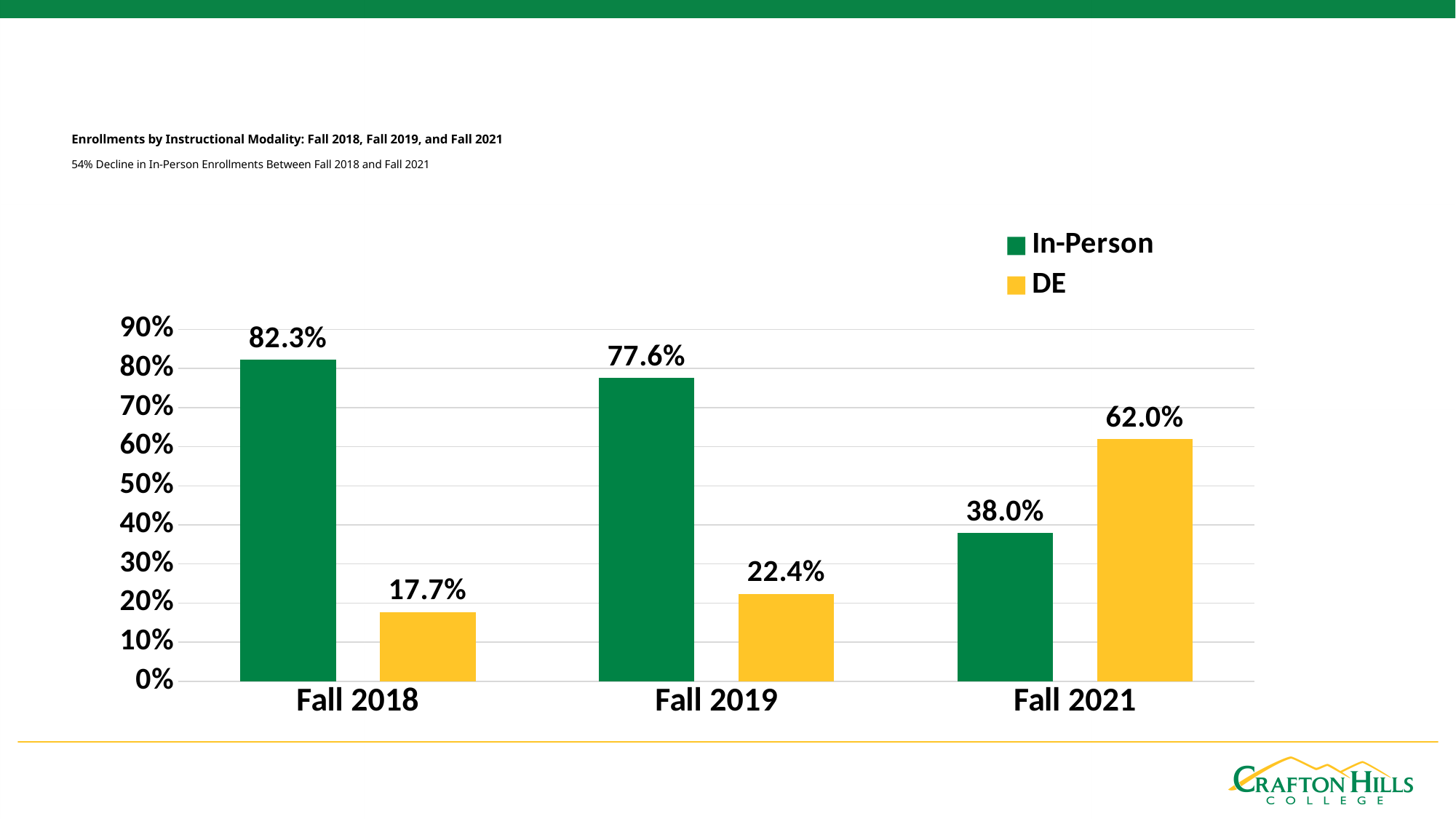
By how many percentage points did the In-Person share fall from Fall 2019 to Fall 2021? 39.6% Which term has the highest DE percentage? Fall 2021 How many terms are shown on the x axis? 3 What is the difference between the In-Person and DE percentages in Fall 2018? 64.6% How many series does the legend list? 2 Does the In-Person percentage rise or fall from Fall 2018 to Fall 2021? Fall What is the In-Person enrollment percentage for Fall 2018? 82.3% Which term has the lowest In-Person percentage? Fall 2021 What is the DE value for Fall 2019? 22.4% What kind of chart is shown on the slide? Bar chart What is the DE enrollment percentage for Fall 2021? 62.0% In Fall 2021, which is larger, In-Person or DE? DE